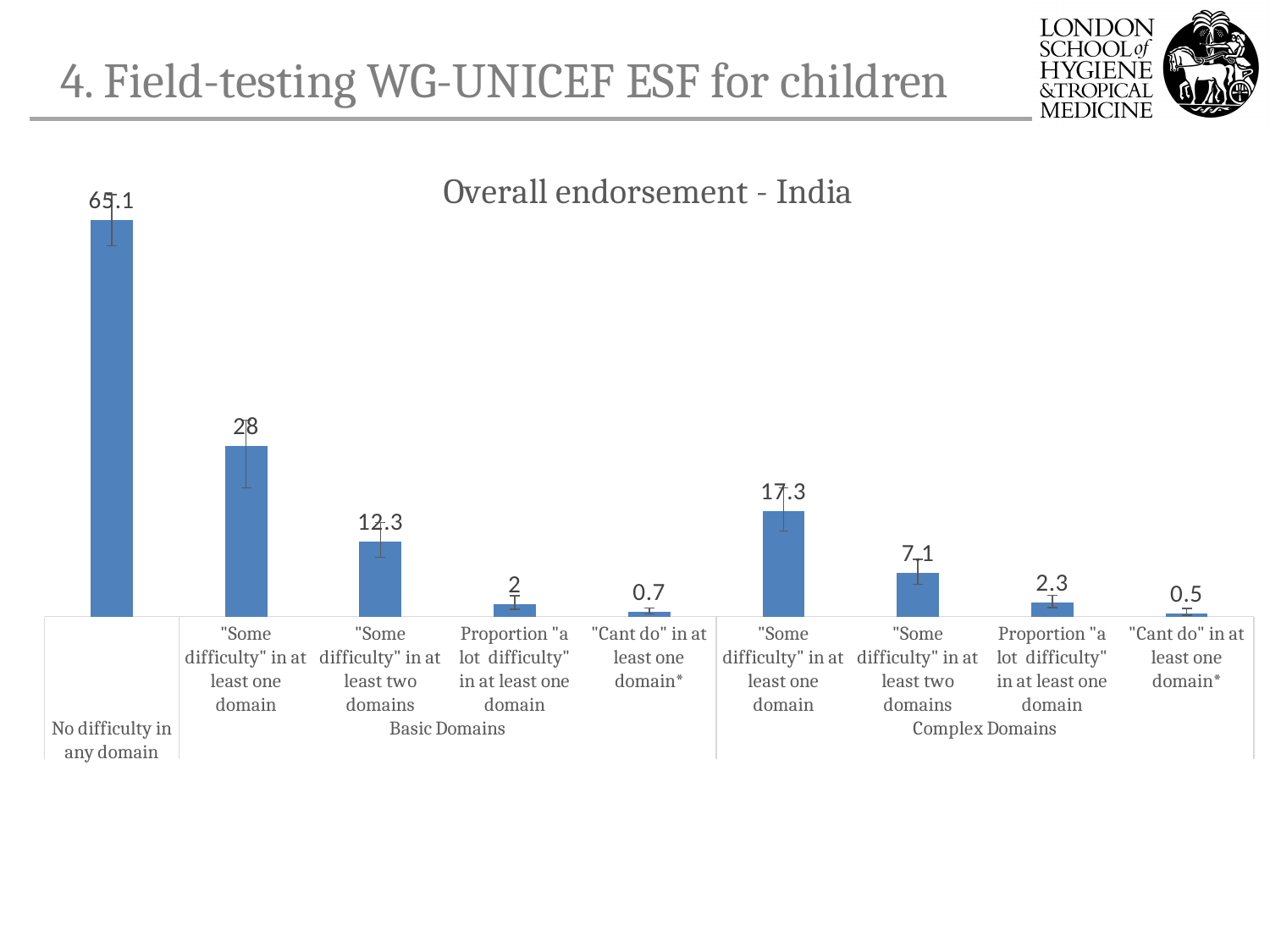
Which is larger: "Some difficulty" in at least two domains for Basic Domains or for Complex Domains? Basic Domains What is the value for "Cant do" in at least one domain under Complex Domains? 0.5 What is the difference between "Some difficulty" in at least one domain for Basic Domains and for Complex Domains? 10.7 Which category has the lowest value? "Cant do" in at least one domain (Complex Domains) How many bars are plotted in the chart? 9 What is the value for "Some difficulty" in at least one domain under Basic Domains? 28 What is the value for "No difficulty in any domain"? 65.1 What is the value for "Some difficulty" in at least one domain under Complex Domains? 17.3 Which category has the highest value? No difficulty in any domain What type of chart is shown on the slide? Bar chart What is the difference between Proportion "a lot difficulty" in at least one domain for Complex Domains and for Basic Domains? 0.3 What is the title of the chart? Overall endorsement - India